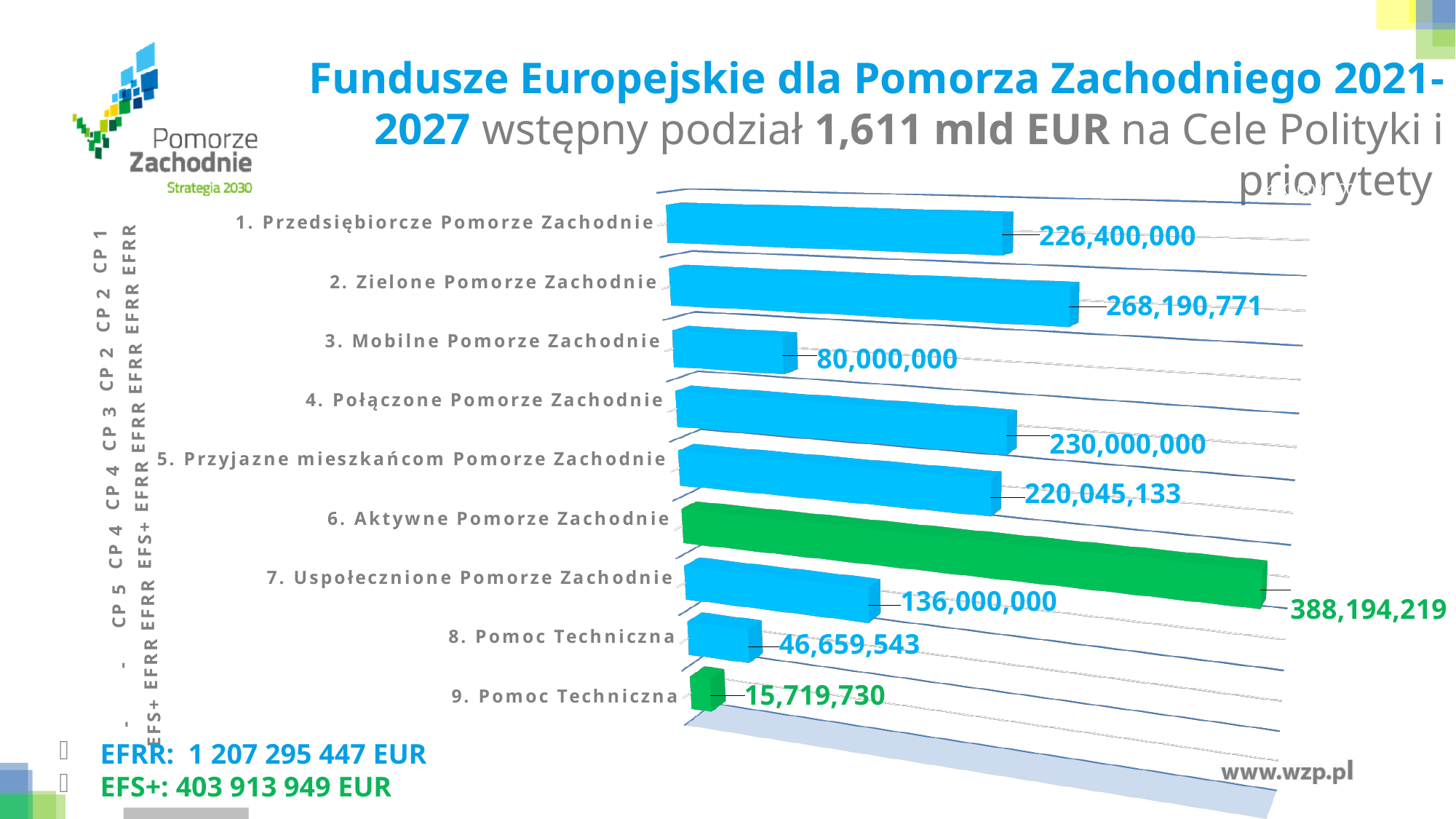
Which is larger, the value for 2. Zielone Pomorze Zachodnie or 5. Przyjazne mieszkańcom Pomorze Zachodnie? 2. Zielone Pomorze Zachodnie What is the difference between the values for 4. Połączone Pomorze Zachodnie and 1. Przedsiębiorcze Pomorze Zachodnie? 3,600,000 What is the value for 1. Przedsiębiorcze Pomorze Zachodnie? 226,400,000 What is the value for 2. Zielone Pomorze Zachodnie? 268,190,771 Which category has the lowest value? 9. Pomoc Techniczna What is the difference between the values for 7. Uspołecznione Pomorze Zachodnie and 3. Mobilne Pomorze Zachodnie? 56,000,000 What colour is the bar for 6. Aktywne Pomorze Zachodnie? Green How many categories are shown in the chart? 9 Which category has the highest value? 6. Aktywne Pomorze Zachodnie What kind of chart is shown on the slide? Bar chart What is the value for 8. Pomoc Techniczna? 46,659,543 What is the value for 6. Aktywne Pomorze Zachodnie? 388,194,219